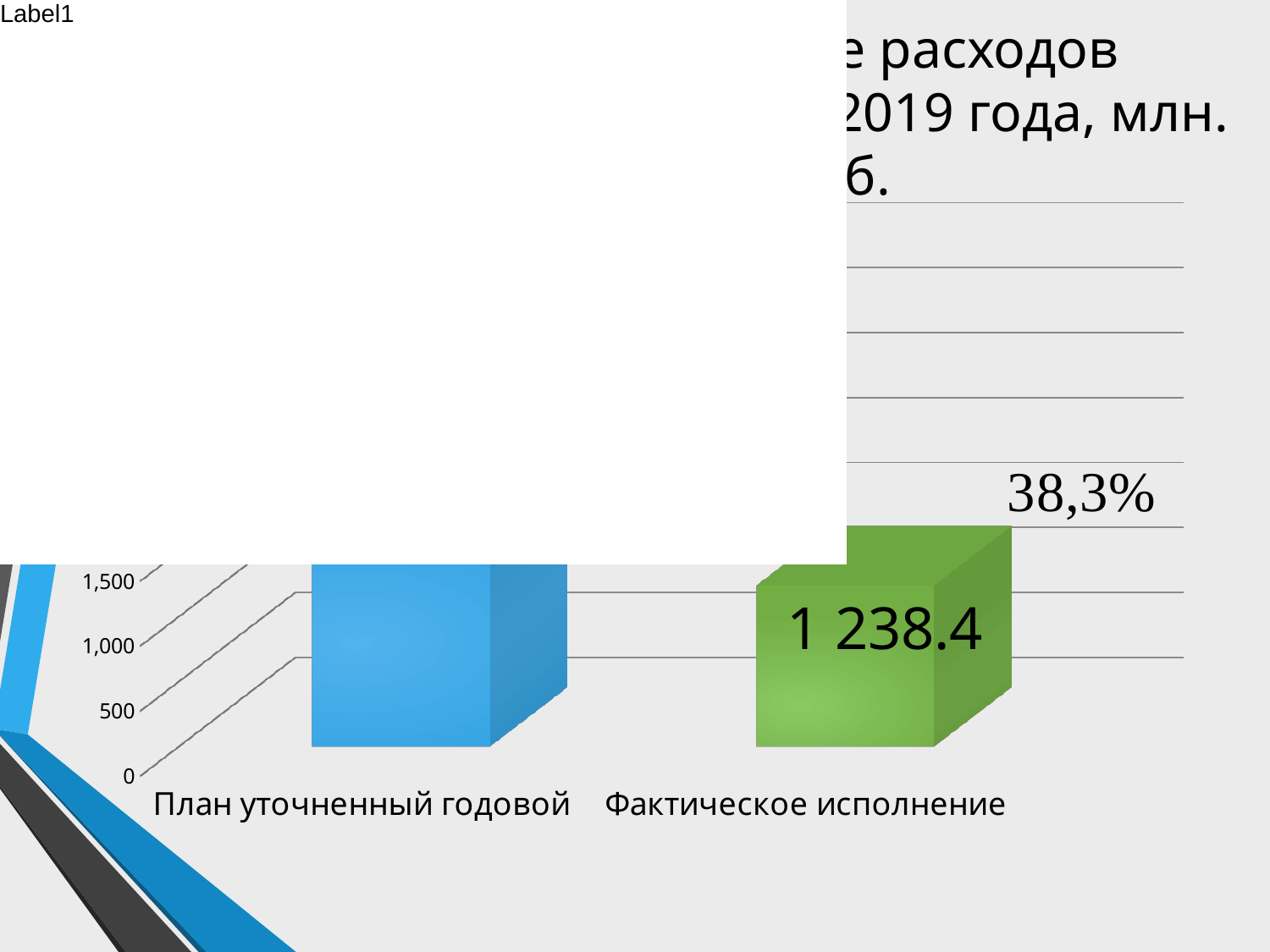
Is the value for План уточненный годовой greater or less than 1,000? greater Which category has the lowest value? Фактическое исполнение Which category has the highest value? План уточненный годовой What colour is the bar for Фактическое исполнение? green What is the value for Фактическое исполнение? 1 238.4 What kind of chart is shown on the slide? bar chart Is the value for Фактическое исполнение greater or less than 1,000? greater Which is larger, the value for План уточненный годовой or the value for Фактическое исполнение? План уточненный годовой What percentage is printed above the Фактическое исполнение bar? 38,3% How many categories are shown on the x axis of the chart? 2 Is the value for Фактическое исполнение greater or less than 1,500? less